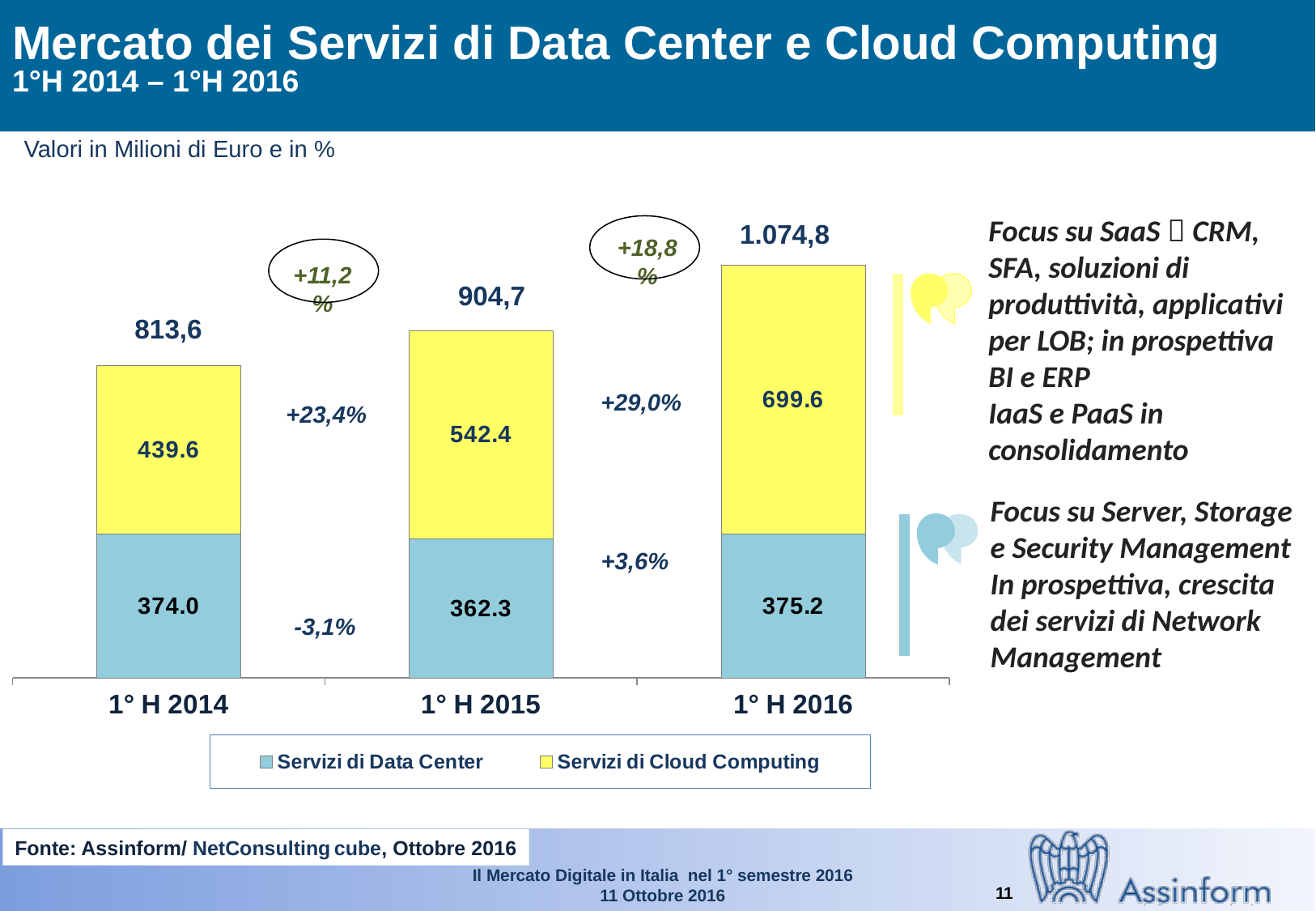
What is the difference between the Servizi di Cloud Computing values in 1° H 2016 and 1° H 2015? 157.2 What is the total value shown above the bar for 1° H 2016? 1.074,8 What percentage growth is shown for Servizi di Cloud Computing between 1° H 2015 and 1° H 2016? +29,0% Which period has the lowest value for Servizi di Data Center? 1° H 2015 What is the value for Servizi di Data Center in 1° H 2015? 362.3 What is the total value shown above the bar for 1° H 2014? 813,6 What is the value for Servizi di Cloud Computing in 1° H 2016? 699.6 What kind of chart is shown on the slide? Stacked bar chart Which period has the highest value for Servizi di Cloud Computing? 1° H 2016 Which is larger in 1° H 2014: Servizi di Data Center or Servizi di Cloud Computing? Servizi di Cloud Computing How many series does the legend list? 2 How many periods are shown on the x axis? 3